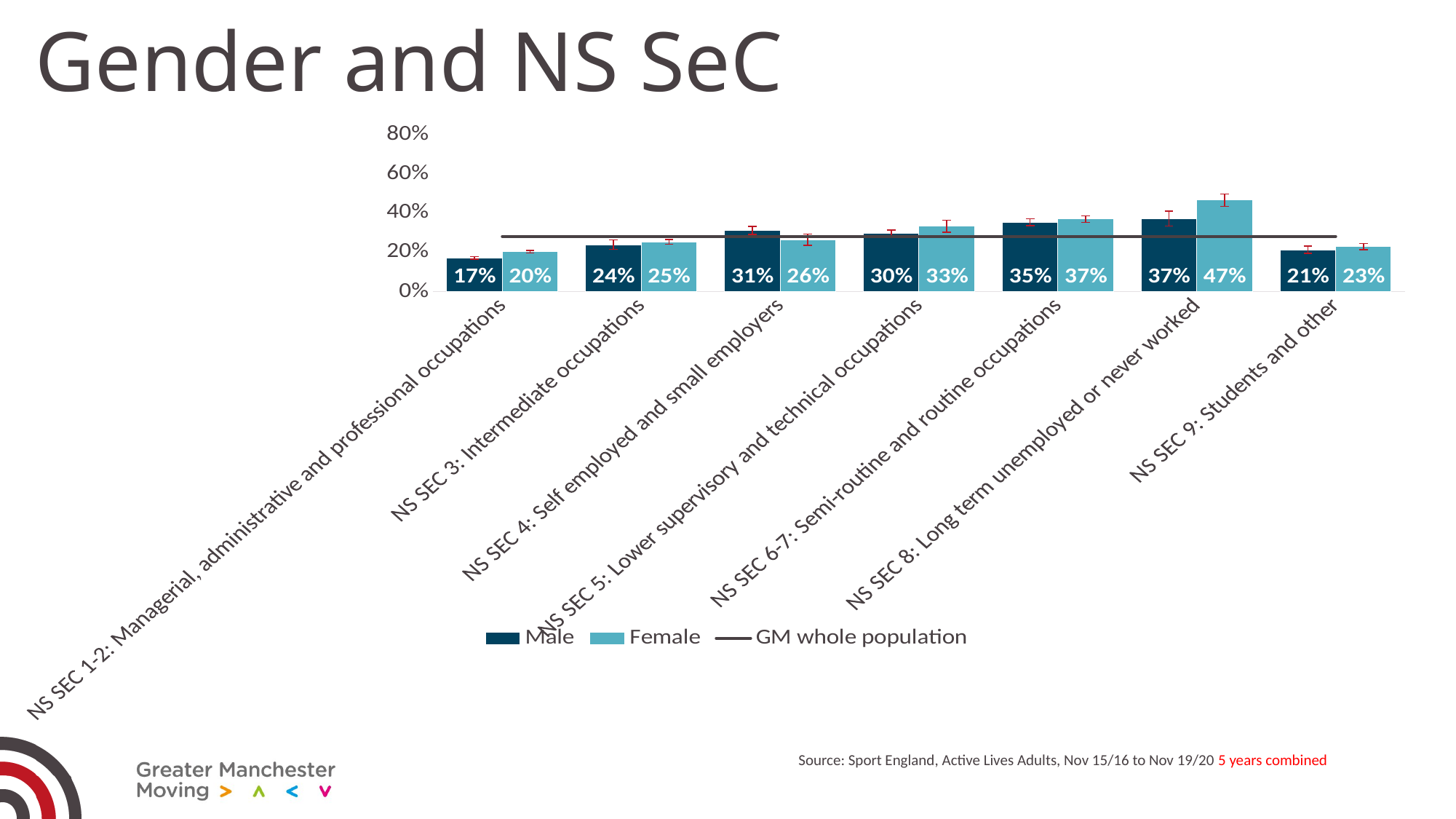
What is the Male value for NS SEC 1-2: Managerial, administrative and professional occupations? 17% Which category has the lowest Male value? NS SEC 1-2: Managerial, administrative and professional occupations What is the title of the slide? Gender and NS SeC What is the difference between the Female and Male values for NS SEC 8: Long term unemployed or never worked? 10% How many entries does the legend list? 3 How many NS SEC categories are shown on the x axis? 7 What kind of chart is shown on the slide? Bar chart What is the Female value for NS SEC 4: Self employed and small employers? 26% Which category has the highest Female value? NS SEC 8: Long term unemployed or never worked What is the Male value for NS SEC 8: Long term unemployed or never worked? 37% For NS SEC 4: Self employed and small employers, which is larger, the Male or the Female value? Male Is the Female value for NS SEC 8: Long term unemployed or never worked greater or less than 40%? greater